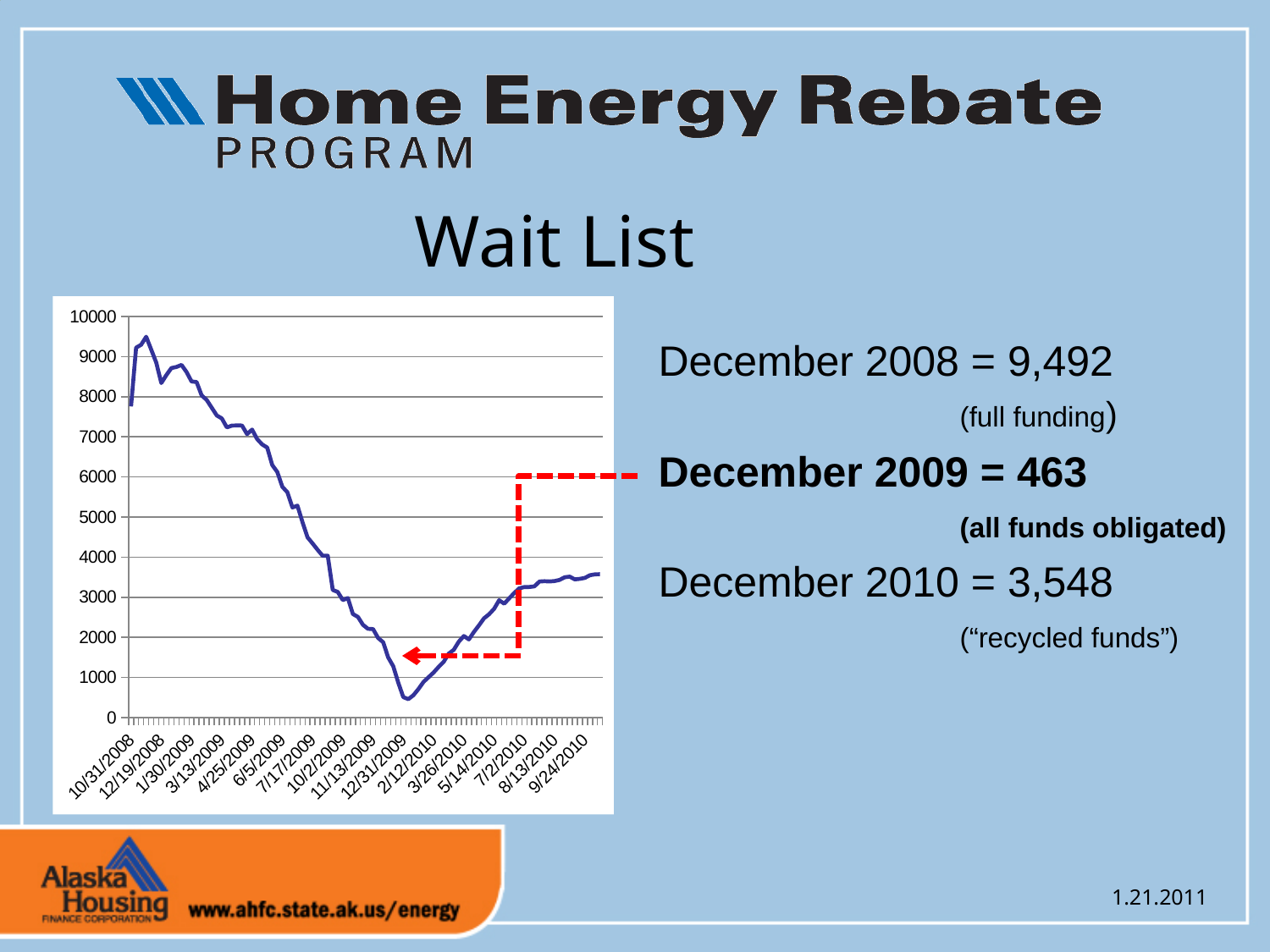
Does the wait list line rise or fall between 10/31/2008 and 12/31/2009? fall What is the difference between the December 2010 and December 2009 wait list values? 3,085 Which is larger, the wait list in December 2008 or in December 2010? December 2008 Is the wait list value at 10/31/2008 greater or less than 7000? greater What is the title of the chart on the slide? Wait List What was the wait list value in December 2010? 3,548 What kind of chart is shown on the slide? line chart What was the wait list value in December 2008? 9,492 Of the three December values given on the slide, which is the lowest? December 2009 What is the difference between the December 2008 and December 2009 wait list values? 9,029 What was the wait list value in December 2009? 463 Of the three December values given on the slide, which is the highest? December 2008